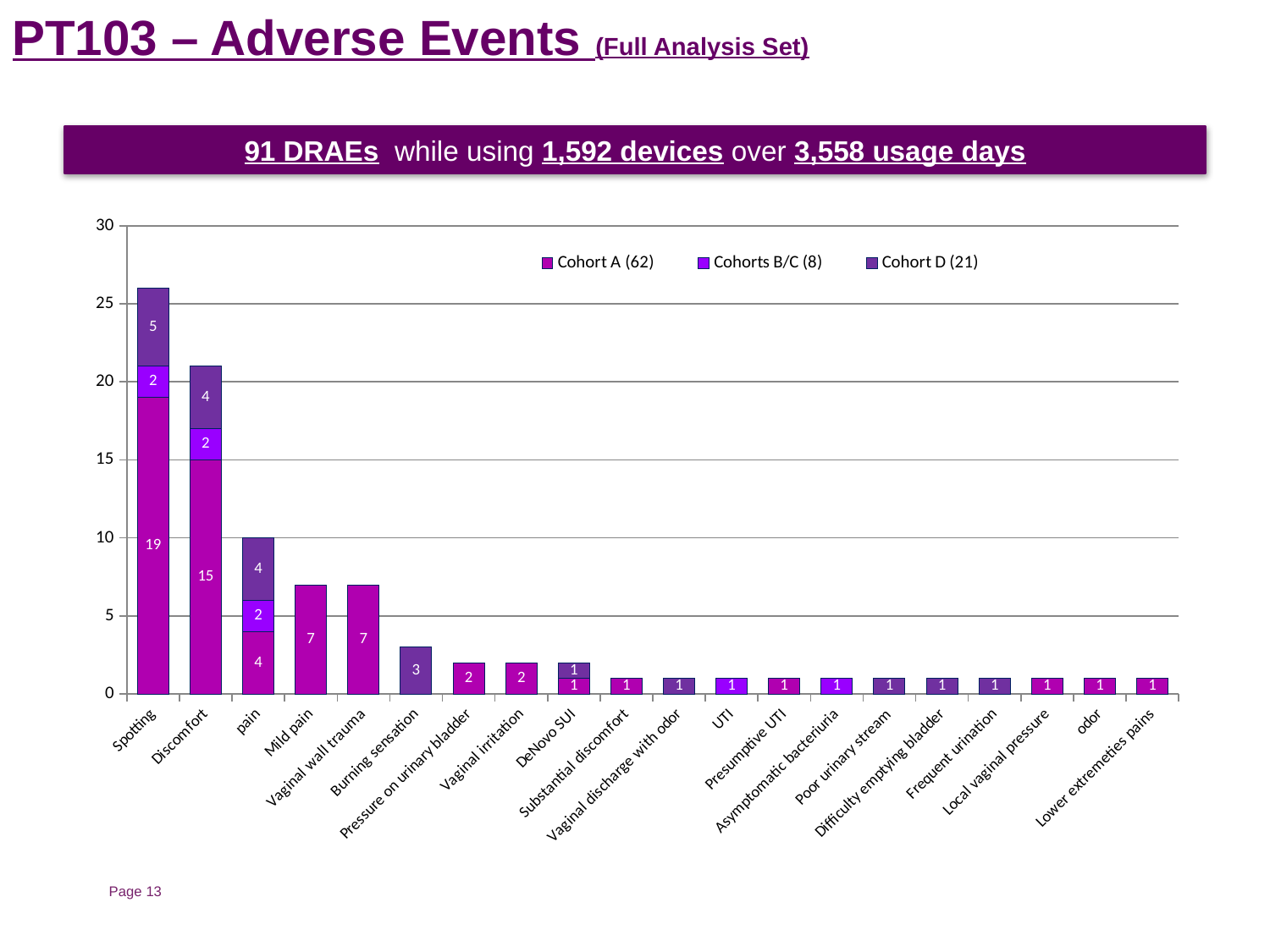
What is the total of the stacked bar for Discomfort? 21 What is the Cohort D (21) value for Discomfort? 4 What is the total of the stacked bar for Spotting? 26 Which category has the highest total stacked bar? Spotting What is the Cohort A (62) value for Spotting? 19 Which is larger, the Cohort A (62) value for Mild pain or the Cohort A (62) value for pain? Mild pain What is the difference between the Cohort A (62) values for Spotting and Discomfort? 4 What is the Cohorts B/C (8) value for pain? 2 What is the Cohort D (21) value for Burning sensation? 3 How many categories are shown on the x axis? 20 What kind of chart is shown on the slide? Stacked bar chart How many series does the legend list? 3